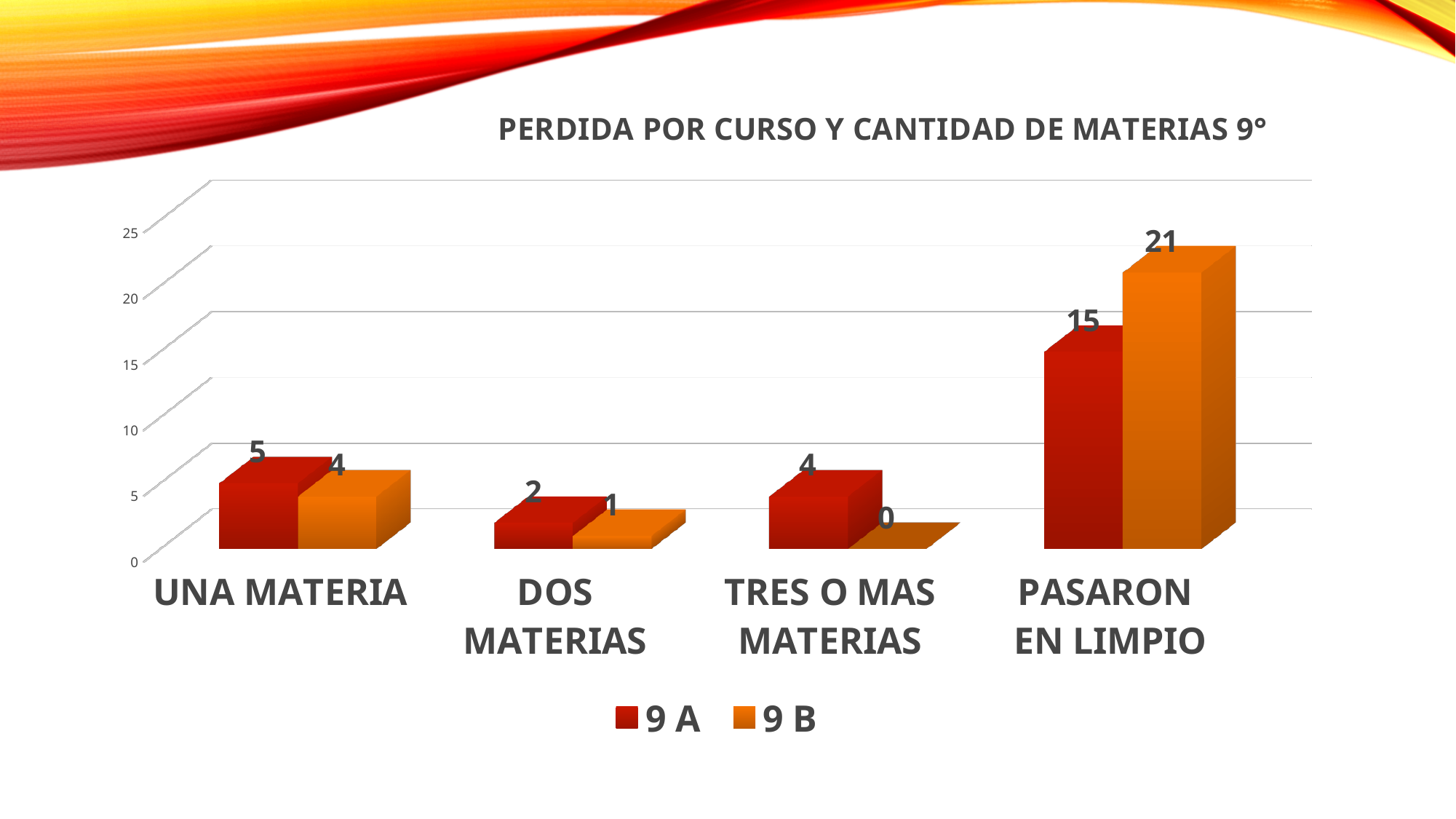
What is the difference between 9 B and 9 A in the PASARON EN LIMPIO category? 6 How many categories are shown on the x axis? 4 How many series does the legend list? 2 What is the title of the chart? PERDIDA POR CURSO Y CANTIDAD DE MATERIAS 9° What is the value for 9 B in the TRES O MAS MATERIAS category? 0 What is the value for 9 A in the UNA MATERIA category? 5 What is the value for 9 B in the PASARON EN LIMPIO category? 21 What is the value for 9 A in the DOS MATERIAS category? 2 In the TRES O MAS MATERIAS category, which series has the larger value, 9 A or 9 B? 9 A Which category has the lowest value for the 9 B series? TRES O MAS MATERIAS Which category has the highest value for the 9 A series? PASARON EN LIMPIO What kind of chart is shown on the slide? Bar chart